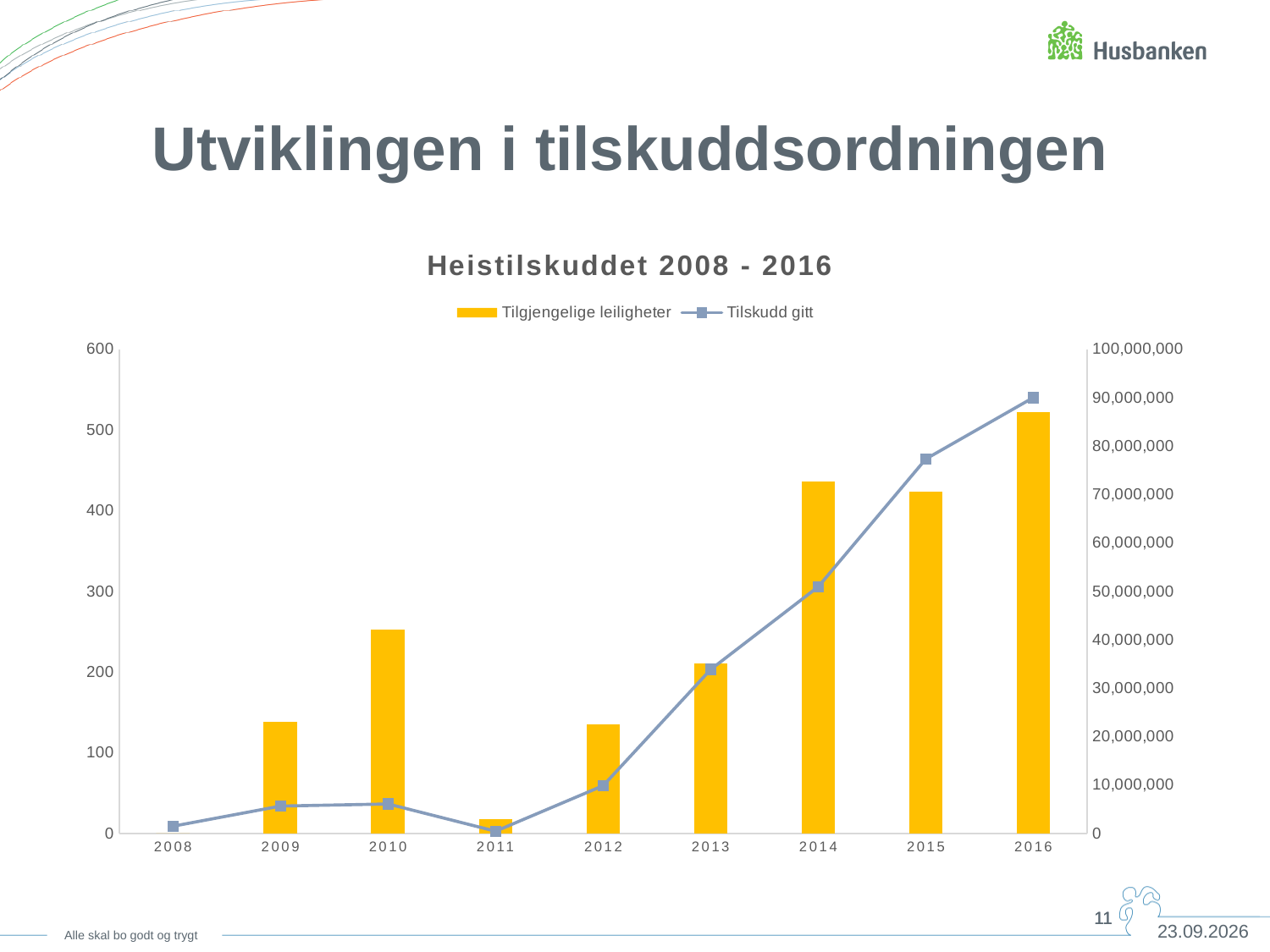
Is the Tilskudd gitt value for 2012 greater or less than 20,000,000? less How many years are shown on the x axis? 9 Does the Tilskudd gitt line rise or fall from 2011 to 2016? rises Is the Tilskudd gitt value for 2015 greater or less than 70,000,000? greater What type of chart is shown on the slide? Combined bar and line chart What is the title of the chart? Heistilskuddet 2008 - 2016 Which year has the lowest point on the Tilskudd gitt line? 2011 Which year has the highest bar for Tilgjengelige leiligheter? 2016 Is the Tilgjengelige leiligheter value for 2016 greater or less than 500? greater Which year has the larger Tilgjengelige leiligheter bar, 2010 or 2012? 2010 How many series does the legend list? 2